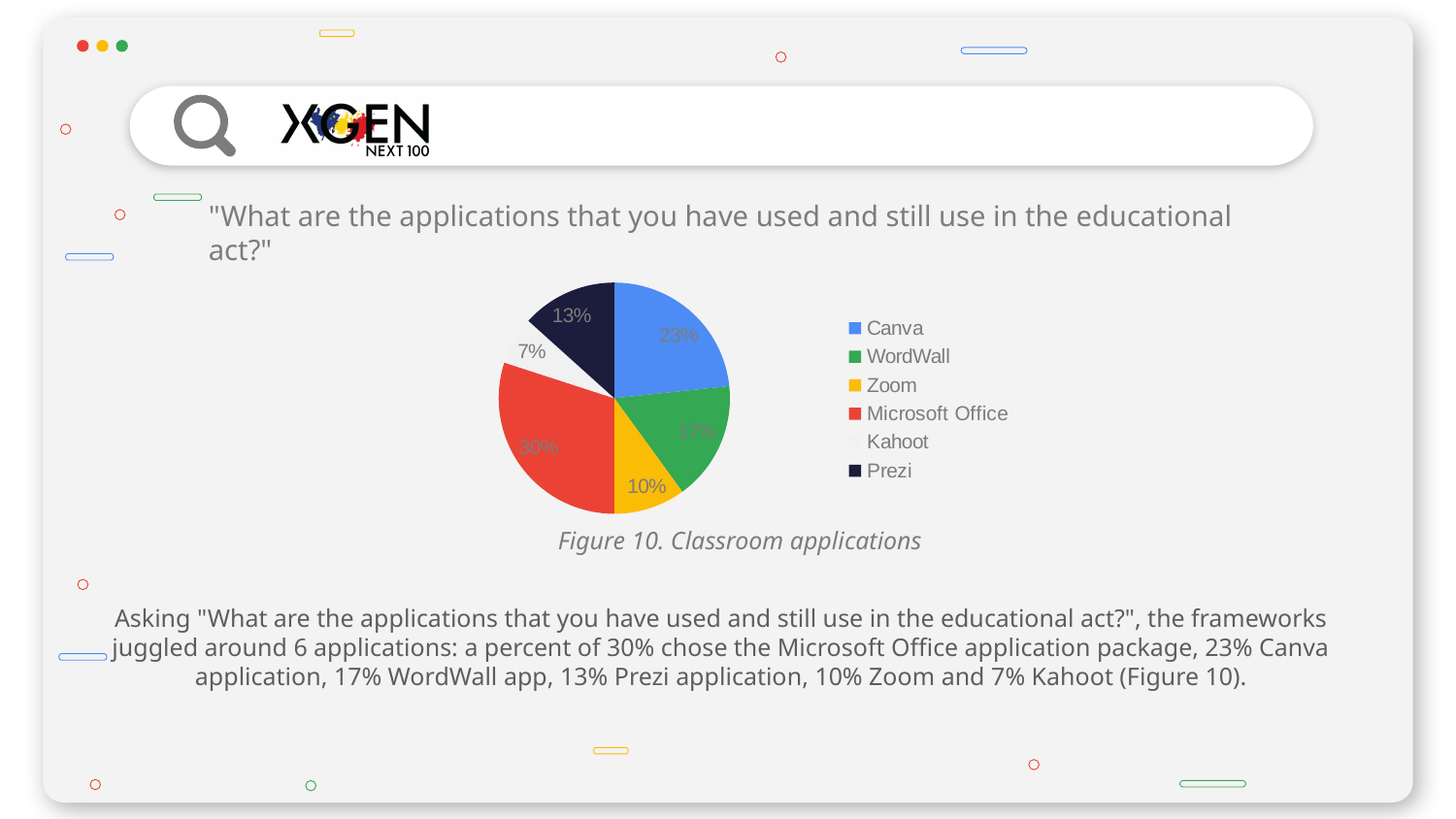
What is the difference in percentage points between Microsoft Office and Canva? 7 Which application has the smallest slice of the pie? Kahoot What is the value shown for WordWall? 17% What is the value shown for Kahoot? 7% Which application has the largest slice of the pie? Microsoft Office What is the value shown for Canva? 23% What is the figure caption below the chart? Figure 10. Classroom applications What kind of chart is shown on the slide? pie chart What percentage of the pie does Microsoft Office account for? 30% What is the value shown for Zoom? 10% Which is larger, the slice for Prezi or the slice for Zoom? Prezi How many applications are listed in the legend? 6